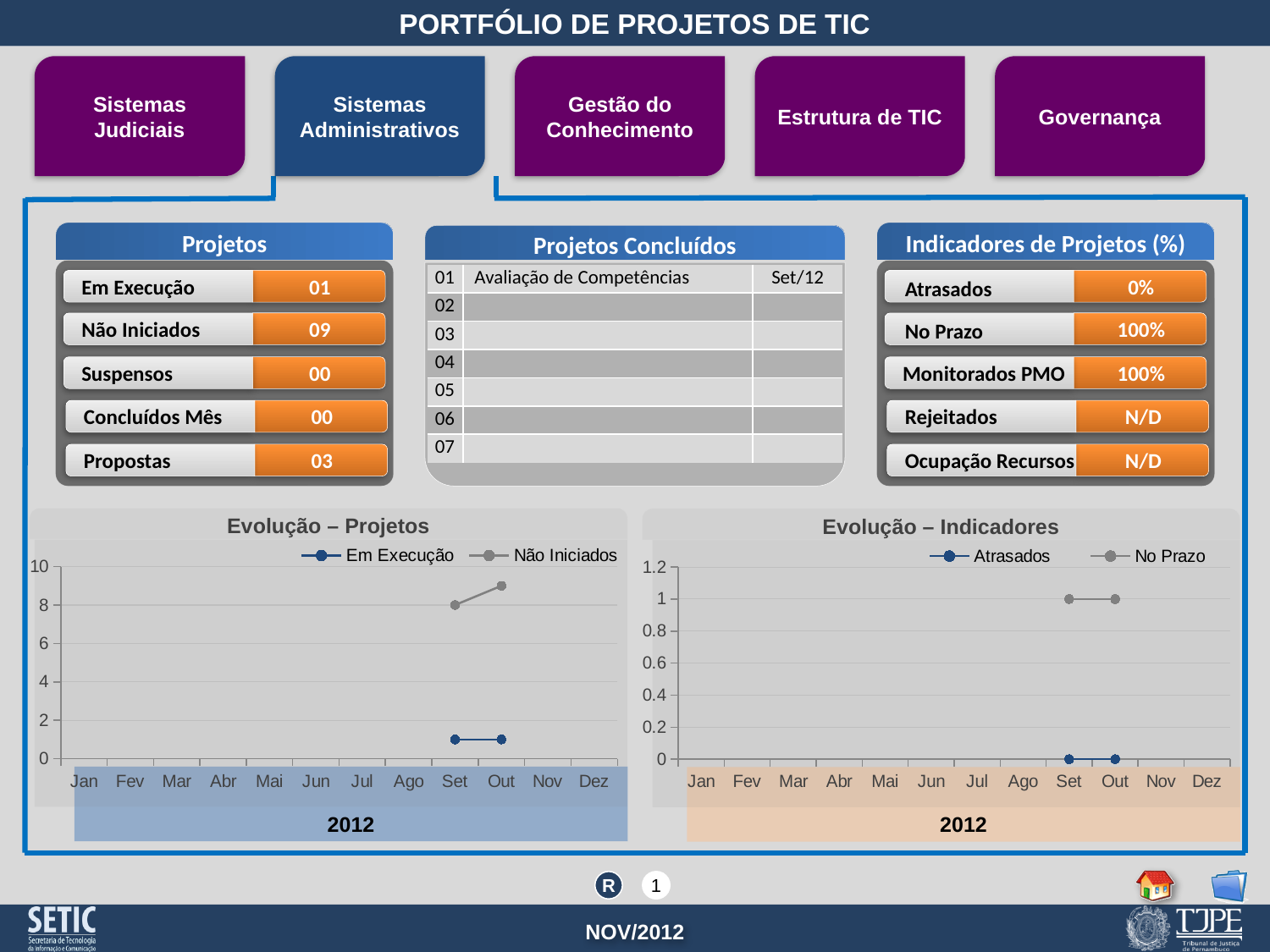
In the 'Evolução – Indicadores' chart, which series is higher in Set, Atrasados or No Prazo? No Prazo In the 'Evolução – Projetos' chart, how many series does the legend list? 2 In the 'Evolução – Indicadores' chart, how many series does the legend list? 2 In the 'Evolução – Projetos' chart, is the value for Em Execução in Set greater or less than 2? less In the 'Evolução – Projetos' chart, what is the value of Não Iniciados in Set? 8 In the 'Evolução – Projetos' chart, is the value for Não Iniciados in Out greater or less than 8? greater In the 'Evolução – Indicadores' chart, what is the value of Atrasados in Set? 0 In the 'Evolução – Projetos' chart, what kind of chart is it? line chart In the 'Evolução – Indicadores' chart, what is the value of No Prazo in Out? 1 In the 'Evolução – Projetos' chart, which series is higher in Out, Em Execução or Não Iniciados? Não Iniciados In the 'Evolução – Projetos' chart, does the Não Iniciados line rise or fall from Set to Out? rise In the 'Evolução – Projetos' chart, what are the two series named in the legend? Em Execução and Não Iniciados